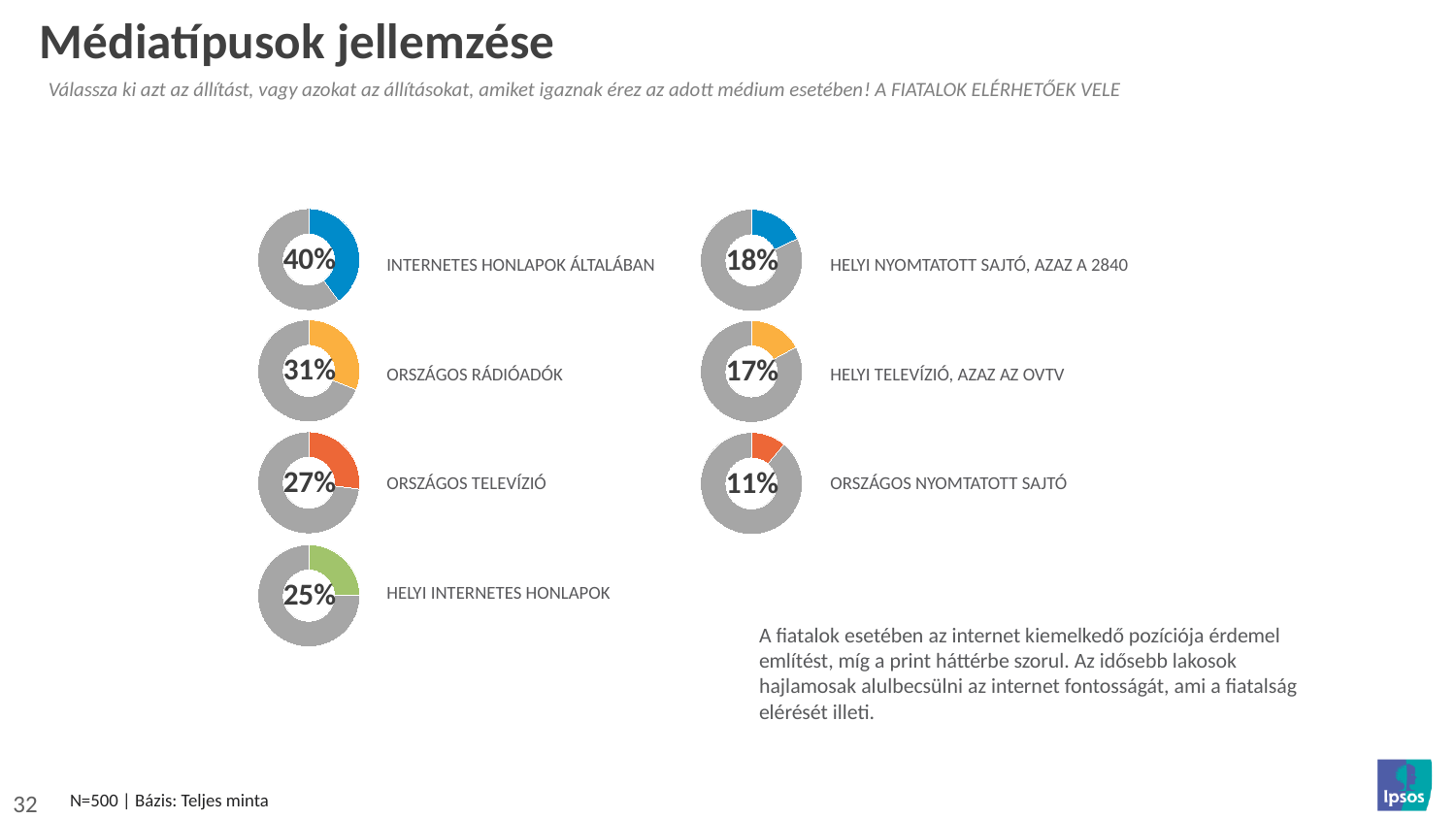
What is the difference between the percentage for INTERNETES HONLAPOK ÁLTALÁBAN and the percentage for HELYI INTERNETES HONLAPOK? 15% What percentage is shown in the donut chart for ORSZÁGOS RÁDIÓADÓK? 31% What percentage is shown in the donut chart for HELYI TELEVÍZIÓ, AZAZ AZ OVTV? 17% What percentage is shown in the donut chart for ORSZÁGOS NYOMTATOTT SAJTÓ? 11% What colour is the highlighted slice in the donut chart for ORSZÁGOS TELEVÍZIÓ? Orange-red How many donut charts are shown on the slide? 7 What kind of chart is used to show the percentage for each medium on the slide? Donut (pie) chart What percentage is shown in the donut chart for HELYI NYOMTATOTT SAJTÓ, AZAZ A 2840? 18% Which has a larger percentage: ORSZÁGOS TELEVÍZIÓ or HELYI TELEVÍZIÓ, AZAZ AZ OVTV? ORSZÁGOS TELEVÍZIÓ What percentage is shown in the donut chart for INTERNETES HONLAPOK ÁLTALÁBAN? 40% Across all the donut charts on the slide, which medium has the lowest percentage? ORSZÁGOS NYOMTATOTT SAJTÓ Across all the donut charts on the slide, which medium has the highest percentage? INTERNETES HONLAPOK ÁLTALÁBAN